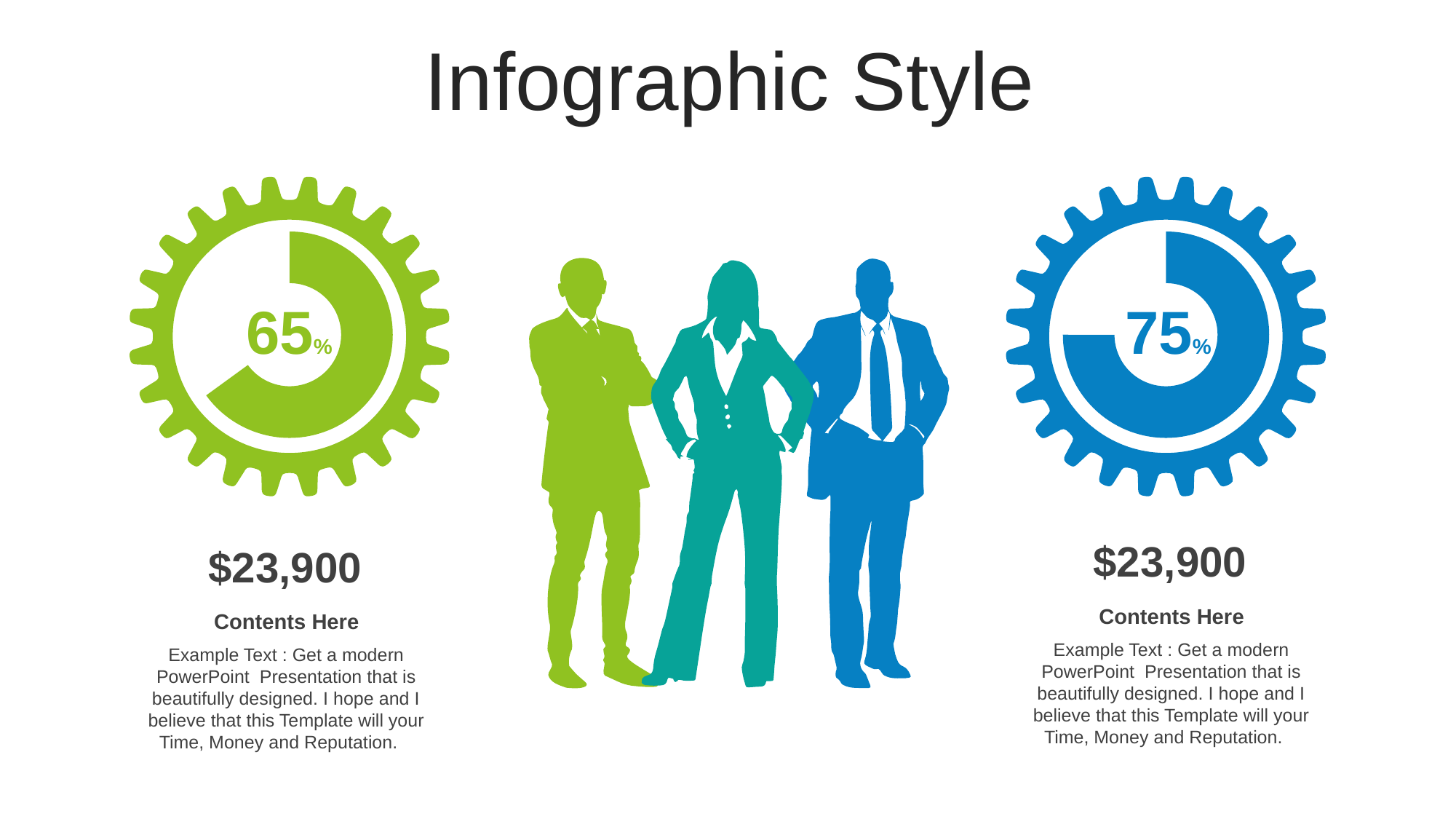
What dollar amount is printed below the right (blue) gear chart? $23,900 Is the value in the right (blue) gear chart greater or less than 80%? less What colour is the gear chart showing 75%? blue Which gear chart shows the higher percentage, the left green one or the right blue one? the right blue one What percentage is shown in the left (green) gear chart? 65% What is the difference in percentage points between the right (blue) gear chart and the left (green) gear chart? 10 What dollar amount is printed below the left (green) gear chart? $23,900 What kind of chart is used inside each gear to show the percentage? donut chart What is the title of the slide? Infographic Style How many gear-shaped percentage charts are on the slide? 2 What percentage is shown in the right (blue) gear chart? 75% Is the value in the left (green) gear chart greater or less than 50%? greater